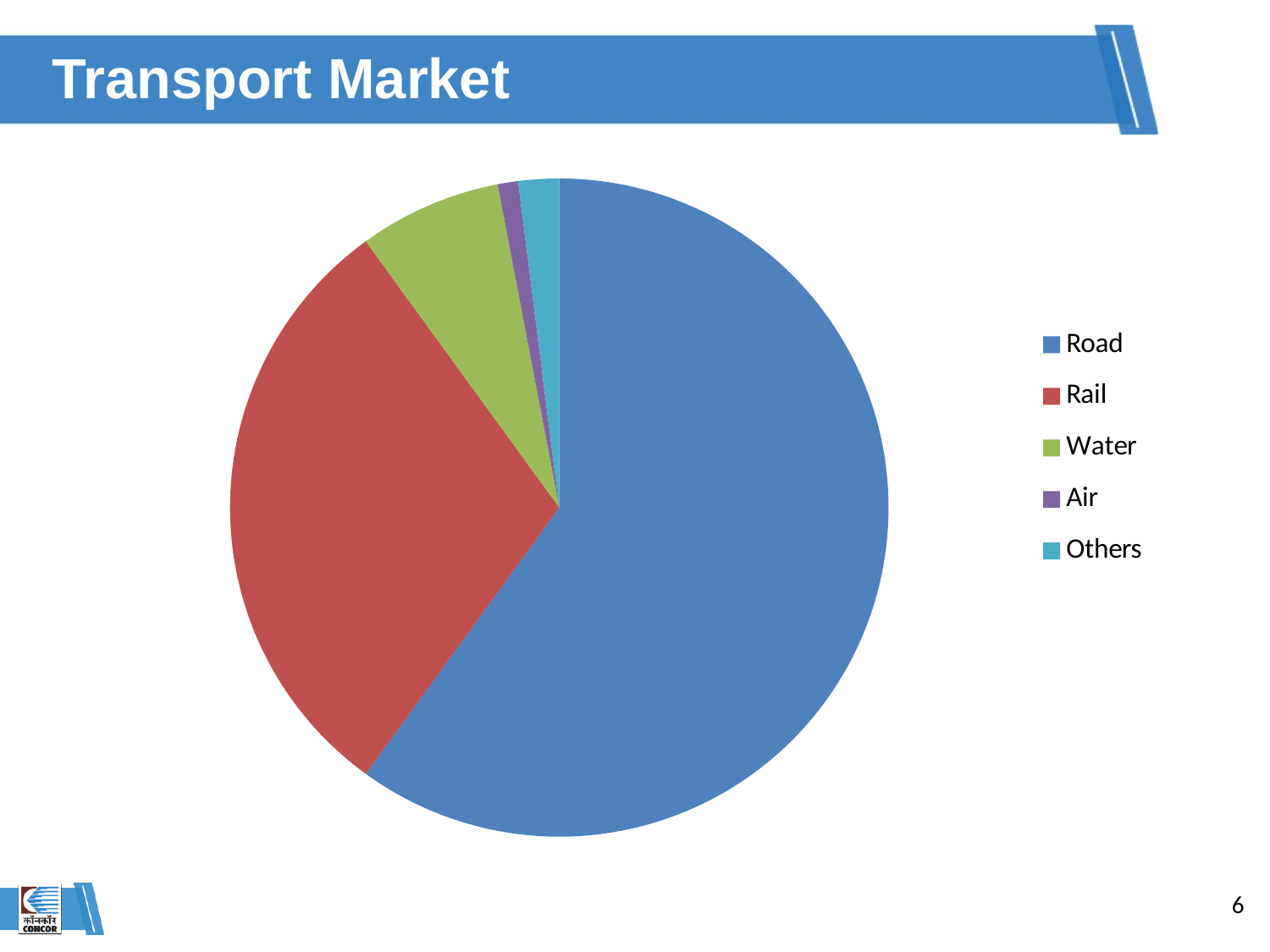
Which slice is larger, Road or Rail? Road Which slice is larger, Rail or Water? Rail What is the title of the slide containing the pie chart? Transport Market Which slice is larger, Water or Air? Water How many slices does the pie chart have? 5 Which category has the smallest slice in the pie chart? Air Which category is shown in red in the pie chart? Rail Which category has the largest slice in the pie chart? Road What kind of chart is shown on the slide? pie chart How many entries does the legend of the pie chart list? 5